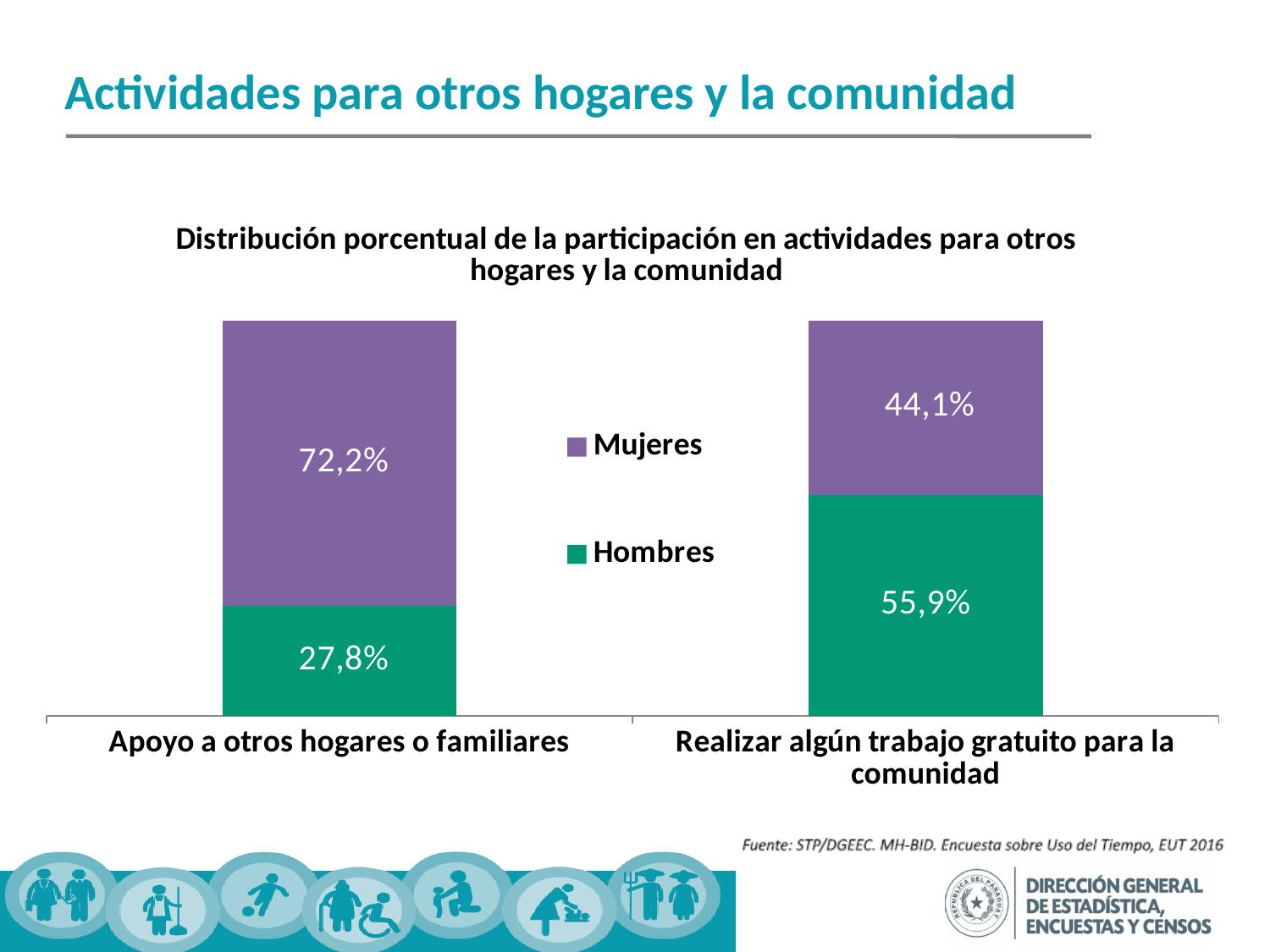
What is the difference between the Mujeres and Hombres shares for 'Apoyo a otros hogares o familiares'? 44,4% How many categories are shown on the x axis? 2 How many series does the legend list? 2 What percentage of Mujeres is shown for 'Apoyo a otros hogares o familiares'? 72,2% Which category has the higher Mujeres share? Apoyo a otros hogares o familiares For 'Realizar algún trabajo gratuito para la comunidad', is the Hombres share larger or smaller than the Mujeres share? larger What is the difference between the Hombres and Mujeres shares for 'Realizar algún trabajo gratuito para la comunidad'? 11,8% What percentage of Hombres is shown for 'Realizar algún trabajo gratuito para la comunidad'? 55,9% What kind of chart is shown on the slide? stacked bar chart Which category has the lower Hombres share? Apoyo a otros hogares o familiares What percentage of Hombres is shown for 'Apoyo a otros hogares o familiares'? 27,8% What percentage of Mujeres is shown for 'Realizar algún trabajo gratuito para la comunidad'? 44,1%